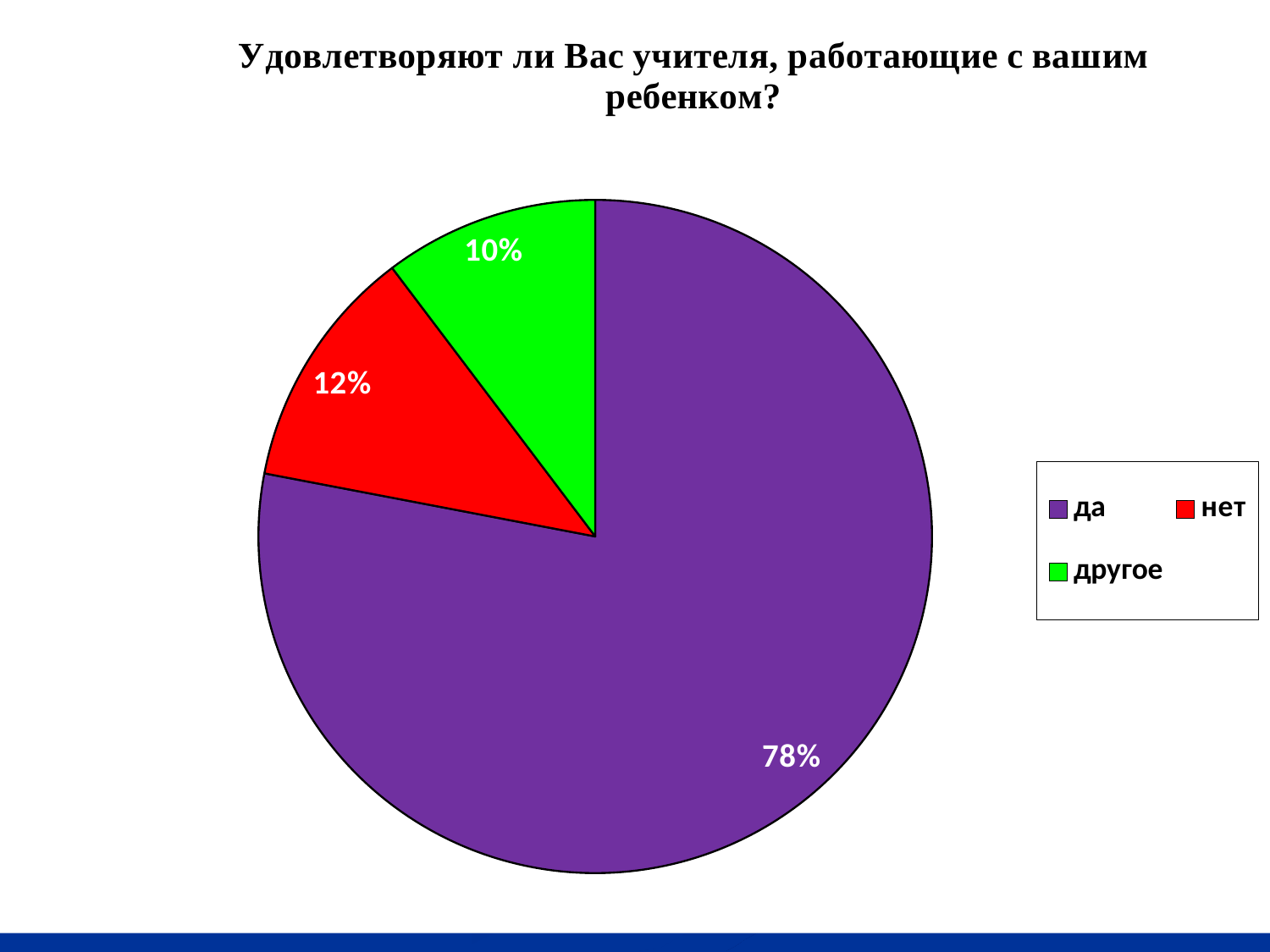
Which category has the smallest slice of the pie? другое What share of the pie does "да" have? 78% Which is larger, the slice for "нет" or the slice for "другое"? нет What share of the pie does "нет" have? 12% What is the difference in percentage points between "нет" and "другое"? 2 What kind of chart is shown on the slide? pie chart What colour is the slice for "нет"? red How many slices does the pie chart have? 3 What share of the pie does "другое" have? 10% What is the difference in percentage points between "да" and "нет"? 66 How many entries does the legend list? 3 Which category has the largest slice of the pie? да